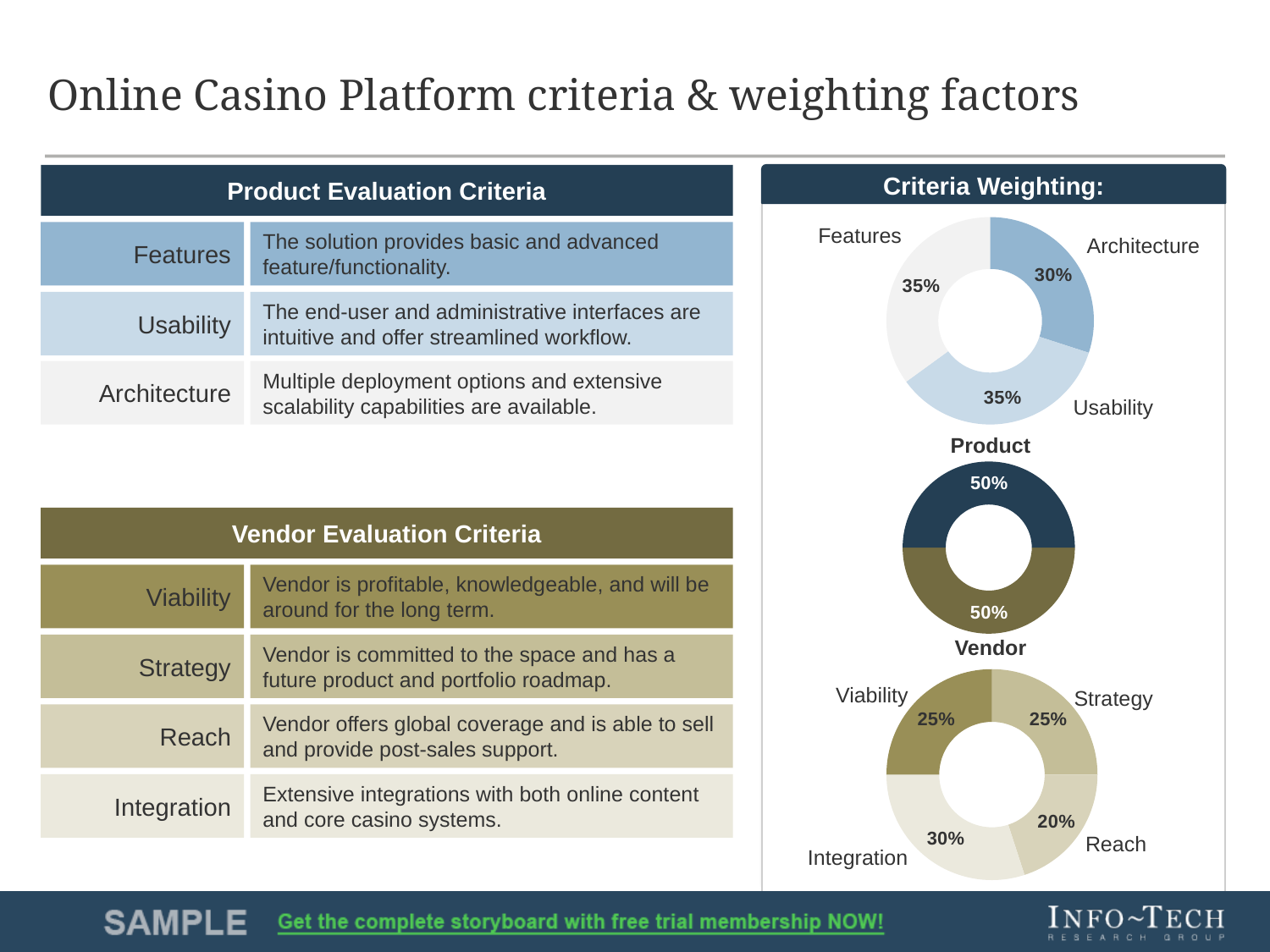
In the bottom donut chart (vendor criteria), which is larger, Viability or Reach? Viability In the top donut chart (product criteria), what is the value for Usability? 35% What kind of chart is used in the Criteria Weighting panel? Donut (pie) chart In the bottom donut chart (vendor criteria), which category has the highest value? Integration In the top donut chart (product criteria), which category has the lowest value? Architecture In the middle donut chart, how many slices are there? 2 In the top donut chart (product criteria), what is the value for Architecture? 30% In the top donut chart (product criteria), how many categories are shown? 3 In the bottom donut chart (vendor criteria), what is the difference between Integration and Reach? 10% In the middle donut chart, what is the value for Vendor? 50% In the bottom donut chart (vendor criteria), what is the value for Reach? 20% In the bottom donut chart (vendor criteria), what is the value for Integration? 30%